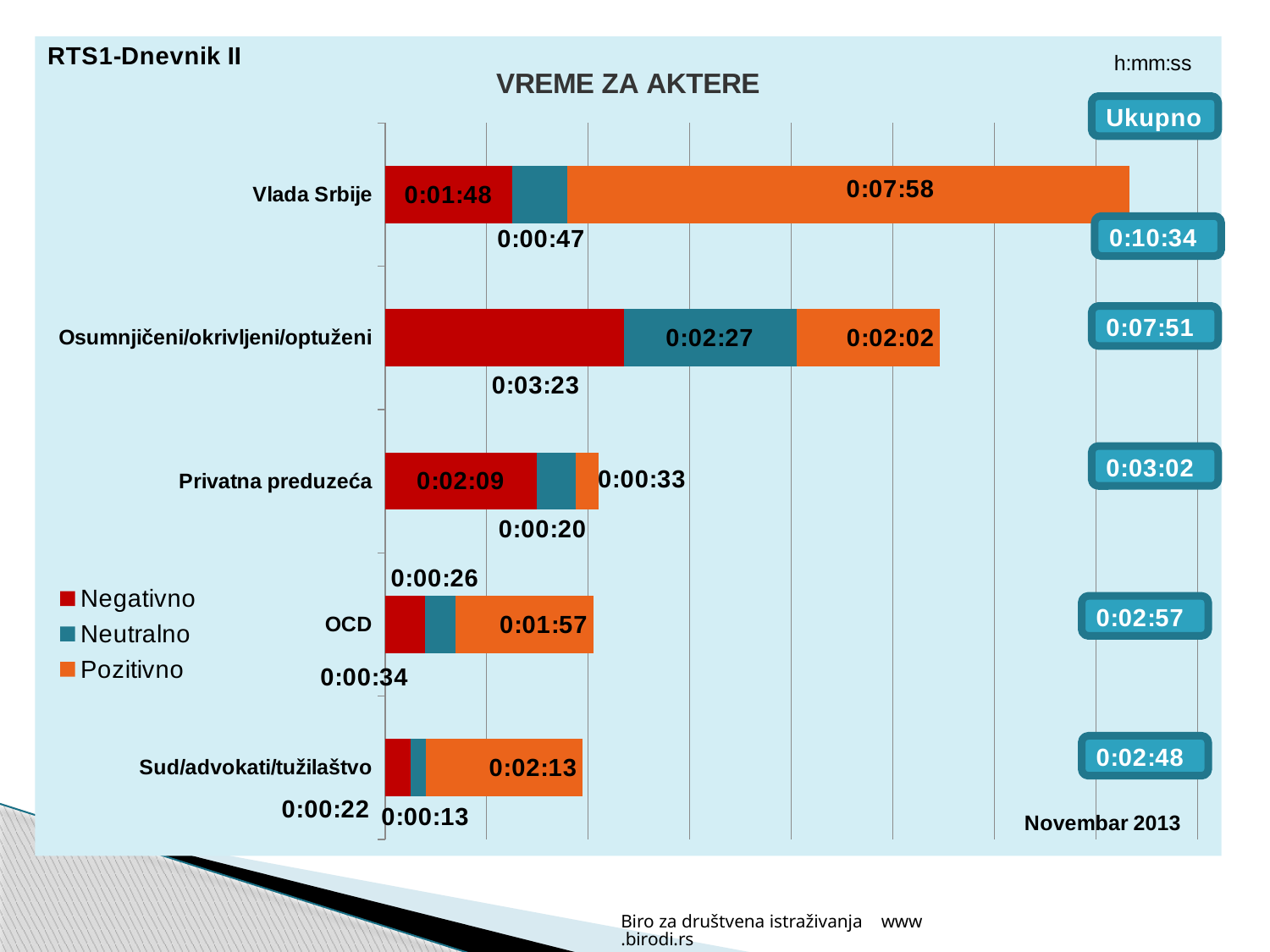
What is the Pozitivno value for Vlada Srbije? 0:07:58 What is the Neutralno value for Sud/advokati/tužilaštvo? 0:00:13 How many series does the legend list? 3 Which category has the highest total (Ukupno) time? Vlada Srbije What kind of chart is shown on the slide? bar chart What are the three entries in the chart's legend? Negativno, Neutralno, Pozitivno What is the total (Ukupno) time for OCD? 0:02:57 Which has the larger Negativno value: Vlada Srbije or Privatna preduzeća? Privatna preduzeća What is the difference between the Pozitivno value for Vlada Srbije and the Pozitivno value for Osumnjičeni/okrivljeni/optuženi? 0:05:56 How many categories (actors) are plotted on the chart? 5 Which category has the lowest total (Ukupno) time? Sud/advokati/tužilaštvo What is the Negativno value for Osumnjičeni/okrivljeni/optuženi? 0:03:23